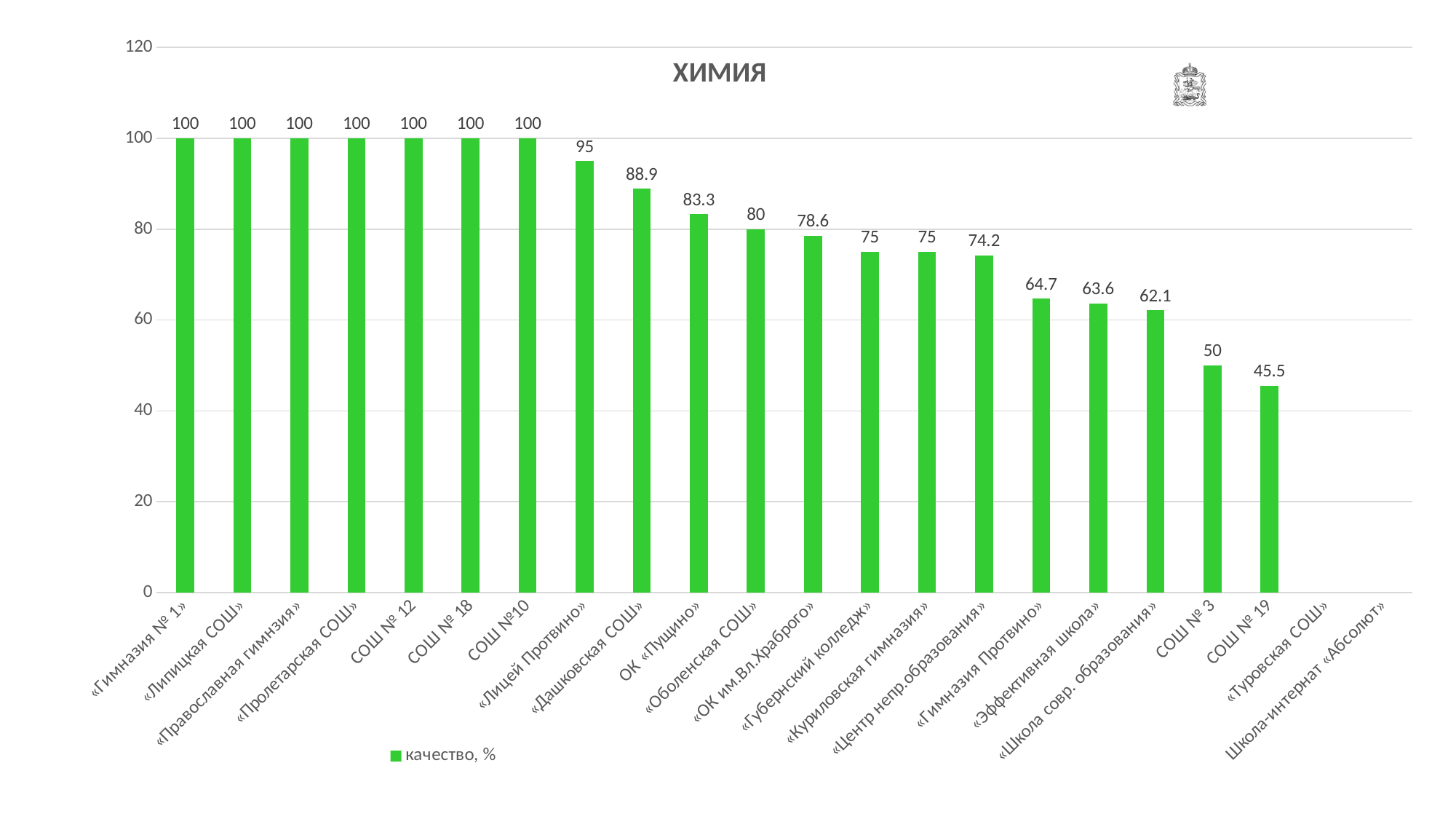
What is the difference between the values for «Лицей Протвино» and «Дашковская СОШ»? 6.1 How many schools have a value of 100? 7 How many series does the legend list? 1 What is the title of the chart? ХИМИЯ What is the value for «Дашковская СОШ»? 88.9 Which is larger, the value for «Гимназия Протвино» or the value for «Эффективная школа»? «Гимназия Протвино» What is the value for СОШ № 19? 45.5 Do the values generally rise or fall from left to right along the x axis? Fall What is the value for «Лицей Протвино»? 95 What is the value for «Центр непр.образования»? 74.2 What type of chart is shown on the slide? Bar chart Which school has the shortest bar on the chart? СОШ № 19